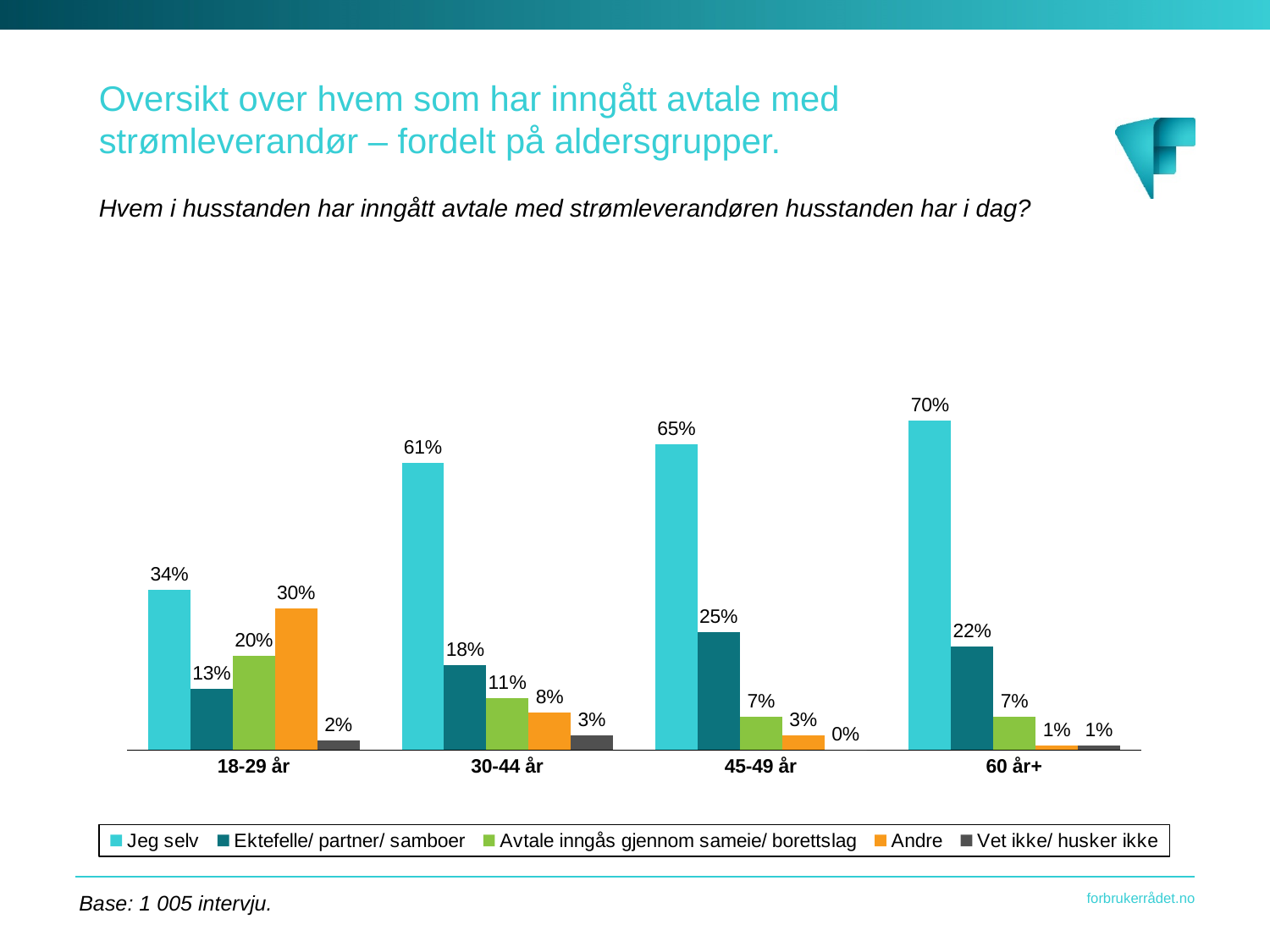
Which age group has the lowest value for "Jeg selv"? 18-29 år What is the value for "Andre" in the 18-29 år group? 30% How many series does the legend list? 5 Which is larger in the 30-44 år group: "Ektefelle/ partner/ samboer" or "Avtale inngås gjennom sameie/ borettslag"? Ektefelle/ partner/ samboer Does the value for "Jeg selv" rise or fall across the age groups from 18-29 år to 60 år+? Rise Which age group has the highest value for "Jeg selv"? 60 år+ What is the value for "Andre" in the 45-49 år group? 3% What is the value for "Jeg selv" in the 18-29 år group? 34% What is the difference between the "Jeg selv" values for 60 år+ and 18-29 år? 36 percentage points What kind of chart is shown on the slide? Bar chart How many age groups are shown on the x axis? 4 What is the value for "Ektefelle/ partner/ samboer" in the 45-49 år group? 25%